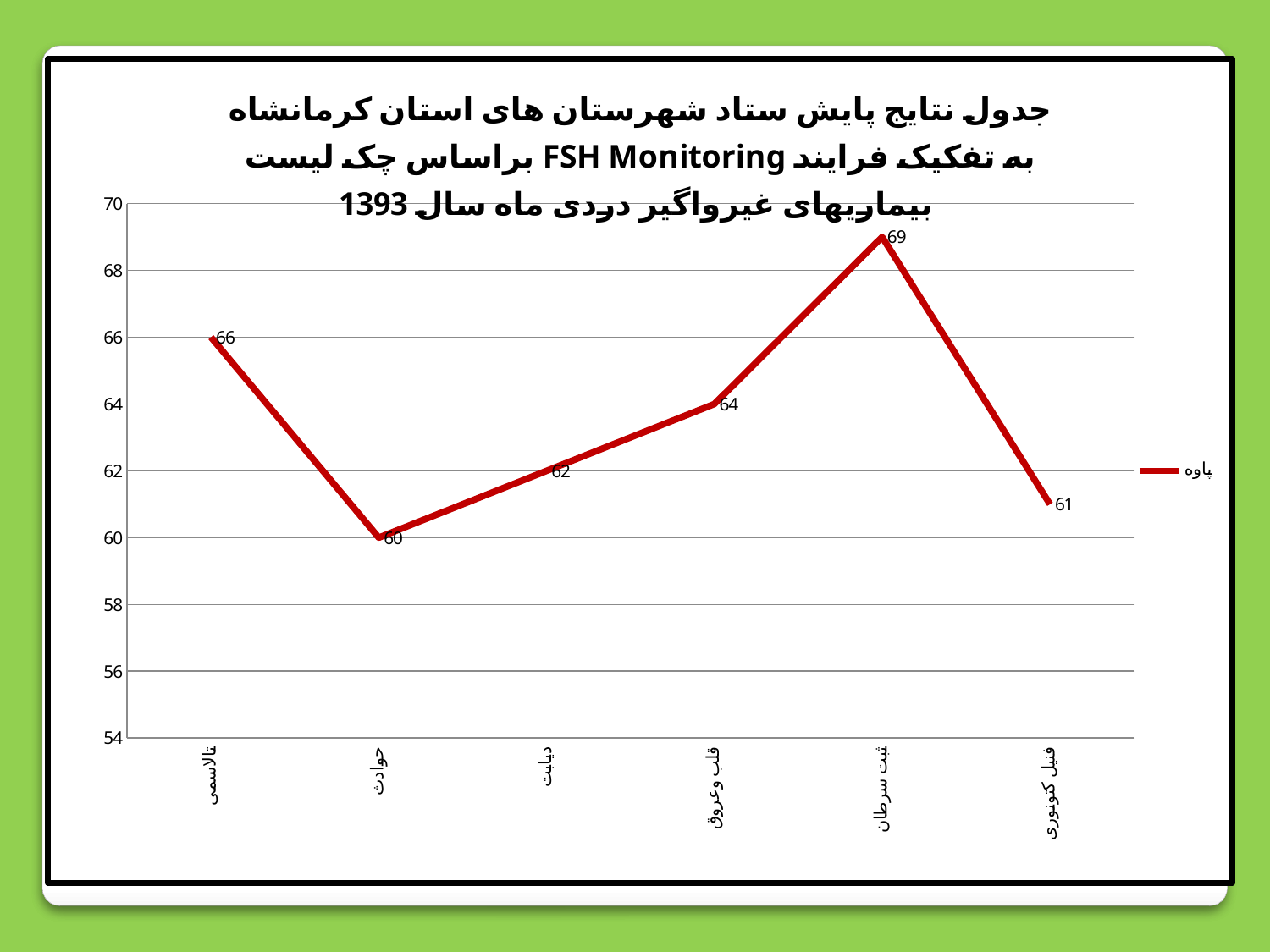
How many series does the legend list? 1 What is the value for فنیل کتونوری? 61 What is the name of the series shown in the legend? پاوه What kind of chart is shown on the slide? line chart Which category has the lowest value? حوادث Which is larger, the value for تالاسمی or the value for قلب وعروق? تالاسمی Which category has the highest value? ثبت سرطان What is the value for تالاسمی? 66 Is the value for دیابت greater or less than 64? less What is the value for ثبت سرطان? 69 How many categories are plotted on the x axis? 6 What is the difference between the values for ثبت سرطان and حوادث? 9